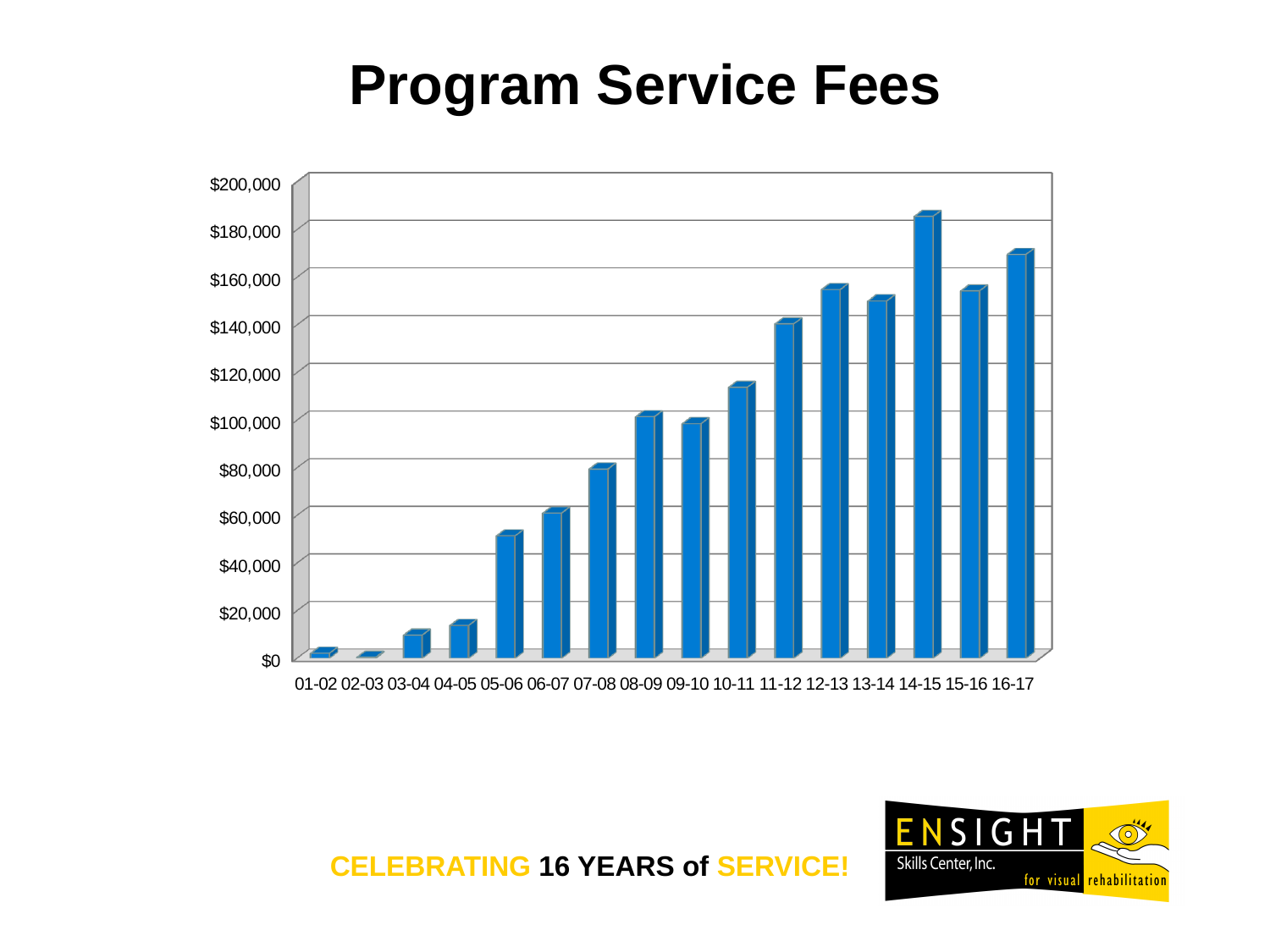
Is the value for 16-17 greater or less than $160,000? greater What kind of chart is shown on the slide? bar chart Is the value for 10-11 greater or less than $100,000? greater Which is larger, the value for 11-12 or the value for 10-11? 11-12 How many fiscal years (categories) are shown on the x axis? 16 Is the value for 14-15 greater or less than $180,000? greater Which fiscal year has the lowest program service fees? 02-03 Do program service fees generally rise or fall from 01-02 to 16-17? rise What is the title of the chart? Program Service Fees Which fiscal year has the highest program service fees? 14-15 Which is larger, the value for 14-15 or the value for 16-17? 14-15